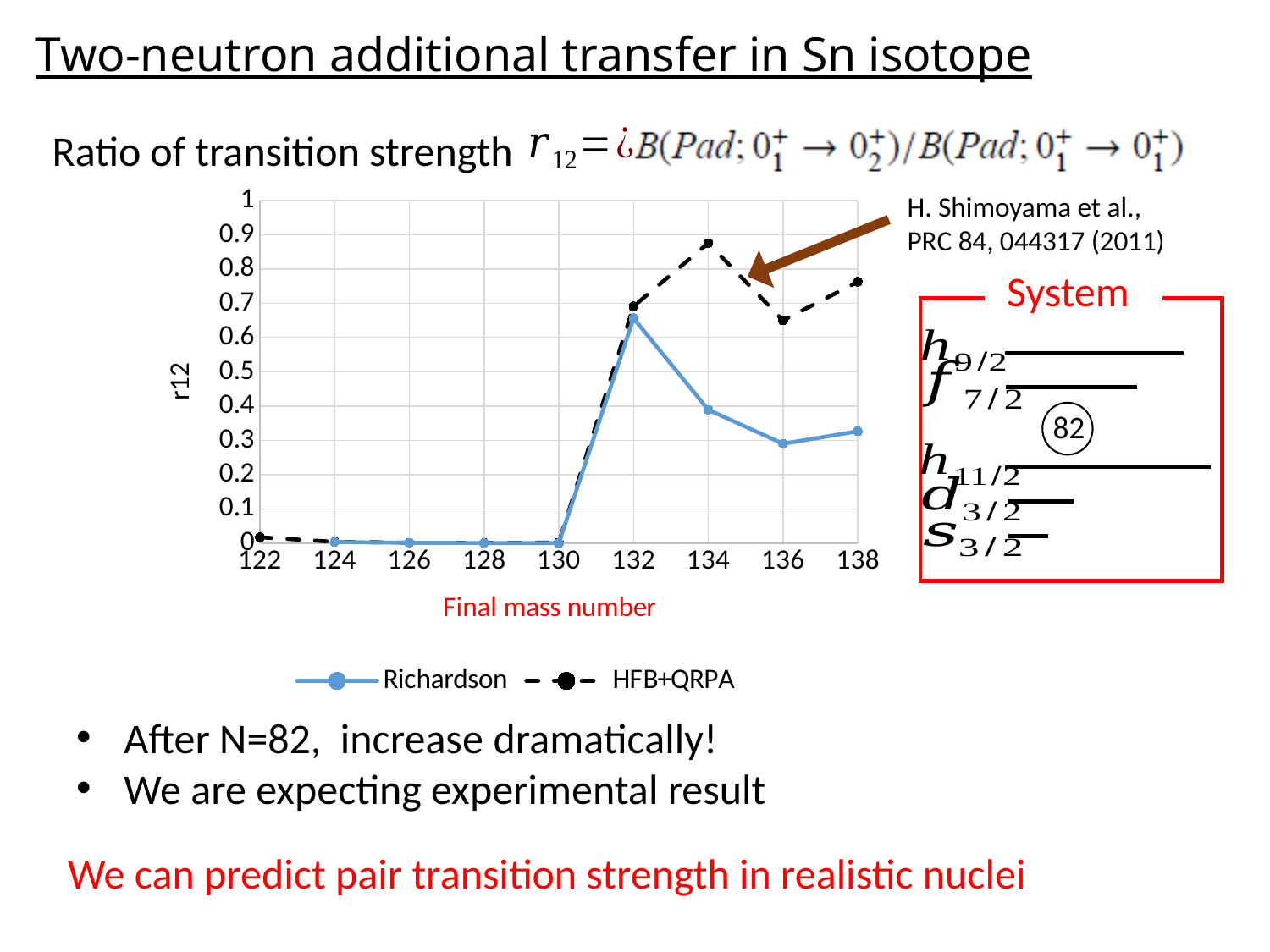
At which final mass number does the HFB+QRPA series reach its highest r12 value? 134 What are the two series named in the chart legend? Richardson and HFB+QRPA Does the Richardson series rise or fall between final mass numbers 132 and 136? fall At which final mass number does the Richardson series reach its highest r12 value? 132 At final mass number 136, which series has the larger r12 value, Richardson or HFB+QRPA? HFB+QRPA Is the HFB+QRPA value at final mass number 136 greater or less than 0.7? less How many final mass number values are marked along the x axis of the chart? 9 Is the HFB+QRPA value at final mass number 134 greater or less than 0.8? greater How many series does the chart legend list? 2 What is the title of the x axis of the chart? Final mass number What kind of chart is shown on the slide? line chart Is the Richardson value at final mass number 134 greater or less than 0.5? less